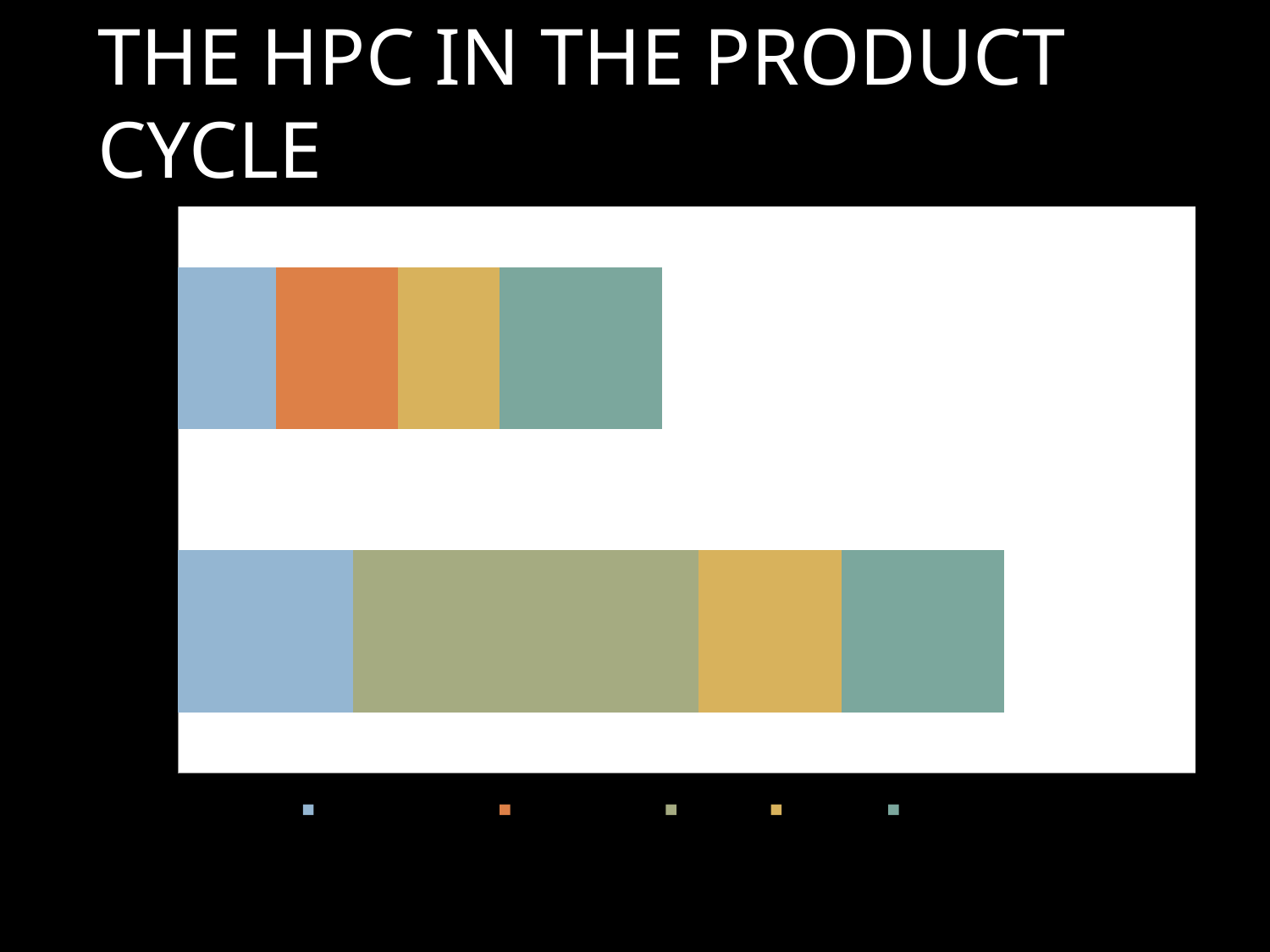
How many bars does the chart contain? 2 Which bar is longer overall, the top bar or the bottom bar? the bottom bar How many coloured segments make up the bottom bar? 4 What kind of chart is shown on the slide? bar chart How many coloured segments make up the top bar? 4 What colour is the leftmost segment of each bar? blue Which segment is the widest in the top bar? the teal segment Are the bars in the chart horizontal or vertical? horizontal How many series does the legend list? 5 Which segment is the widest in the bottom bar? the green segment